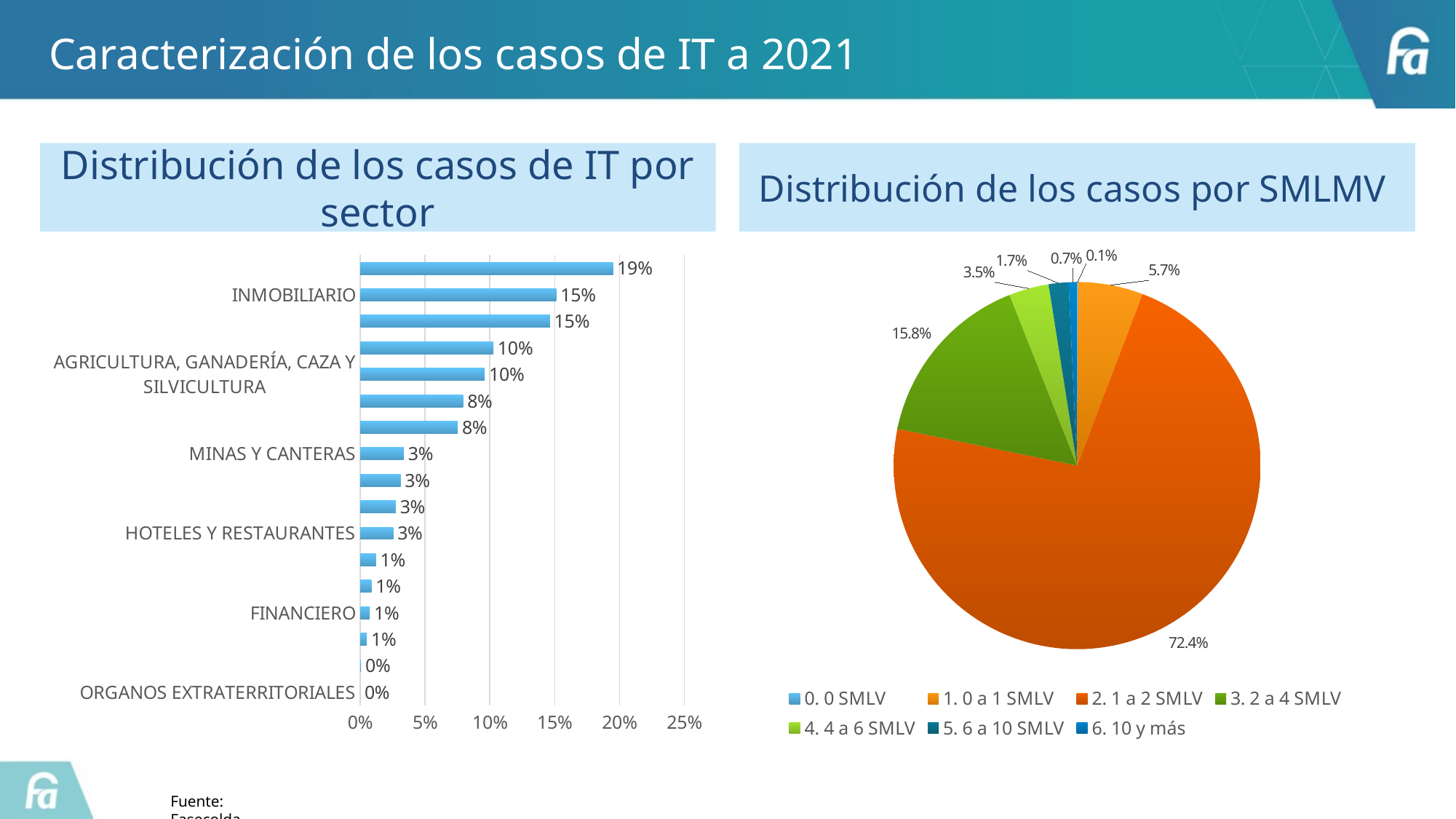
In the pie chart 'Distribución de los casos por SMLMV', which category has the smallest slice? 0. 0 SMLV In the bar chart 'Distribución de los casos de IT por sector', what is the value for INMOBILIARIO? 15% In the bar chart 'Distribución de los casos de IT por sector', what is the value for MINAS Y CANTERAS? 3% What kind of chart is 'Distribución de los casos de IT por sector'? Bar chart In the bar chart 'Distribución de los casos de IT por sector', what is the difference between INMOBILIARIO and HOTELES Y RESTAURANTES? 12% In the bar chart 'Distribución de los casos de IT por sector', what is the value for ORGANOS EXTRATERRITORIALES? 0% In the pie chart 'Distribución de los casos por SMLMV', what share does the '2. 1 a 2 SMLV' slice have? 72.4% In the bar chart 'Distribución de los casos de IT por sector', what is the value of the longest bar? 19% How many entries does the legend of the pie chart 'Distribución de los casos por SMLMV' list? 7 In the bar chart 'Distribución de los casos de IT por sector', which is larger, INMOBILIARIO or FINANCIERO? INMOBILIARIO In the bar chart 'Distribución de los casos de IT por sector', what is the value for FINANCIERO? 1% In the pie chart 'Distribución de los casos por SMLMV', what share does the '3. 2 a 4 SMLV' slice have? 15.8%